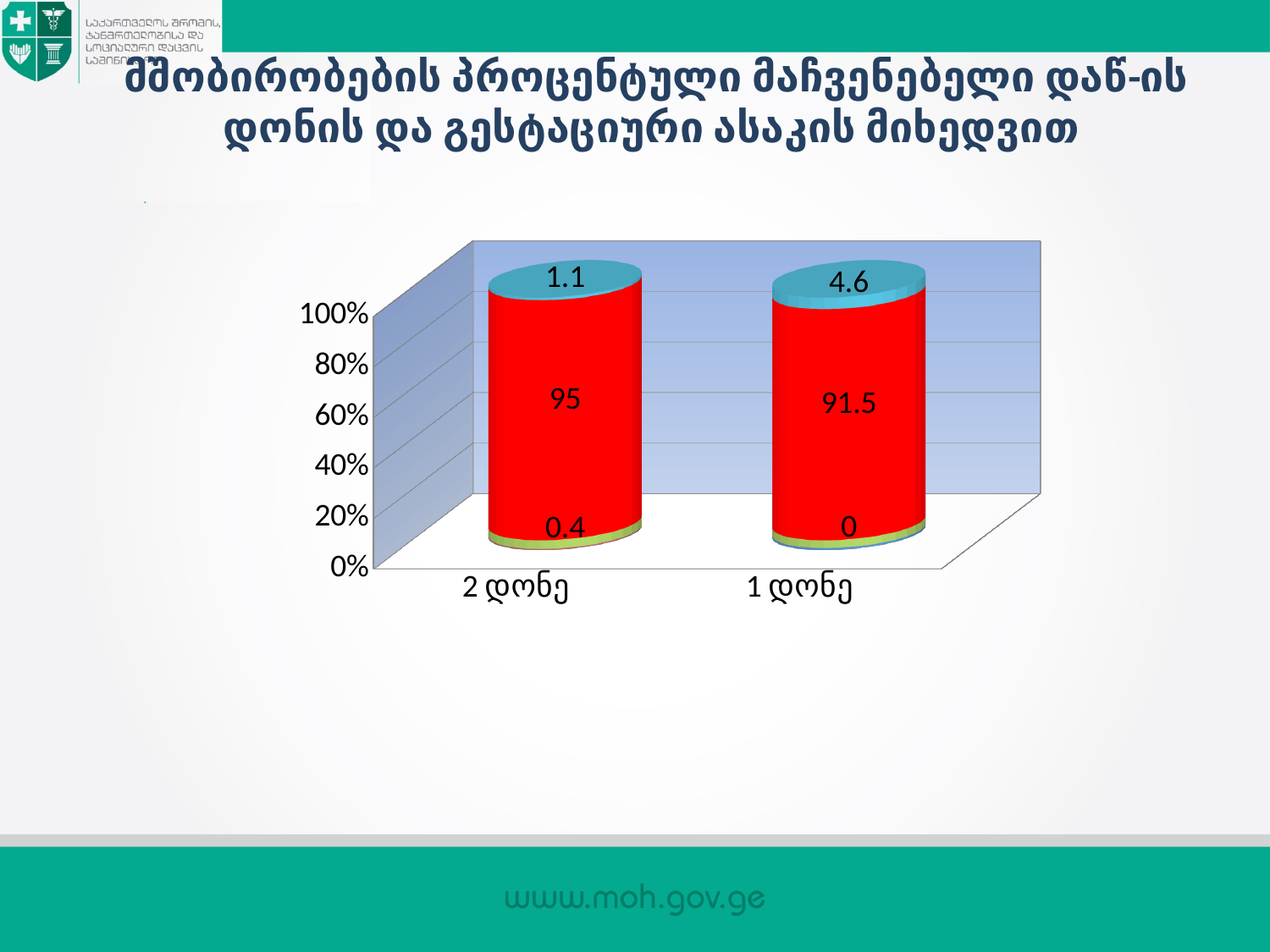
What is the value of the red (middle) segment for 2 დონე? 95 What is the difference between the red segment values of 2 დონე and 1 დონე? 3.5 What is the value of the top (blue) segment for 1 დონე? 4.6 What kind of chart is shown on the slide? Stacked bar chart How many categories are shown on the x axis of the chart? 2 What is the value of the bottom (green) segment for 2 დონე? 0.4 What is the value of the bottom segment for 1 დონე? 0 What is the difference between the top (blue) segment values of 1 დონე and 2 დონე? 3.5 What is the value of the red (middle) segment for 1 დონე? 91.5 What is the value of the top (blue) segment for 2 დონე? 1.1 Which category has the larger red (middle) segment, 2 დონე or 1 დონე? 2 დონე Which category has the larger top (blue) segment, 2 დონე or 1 დონე? 1 დონე